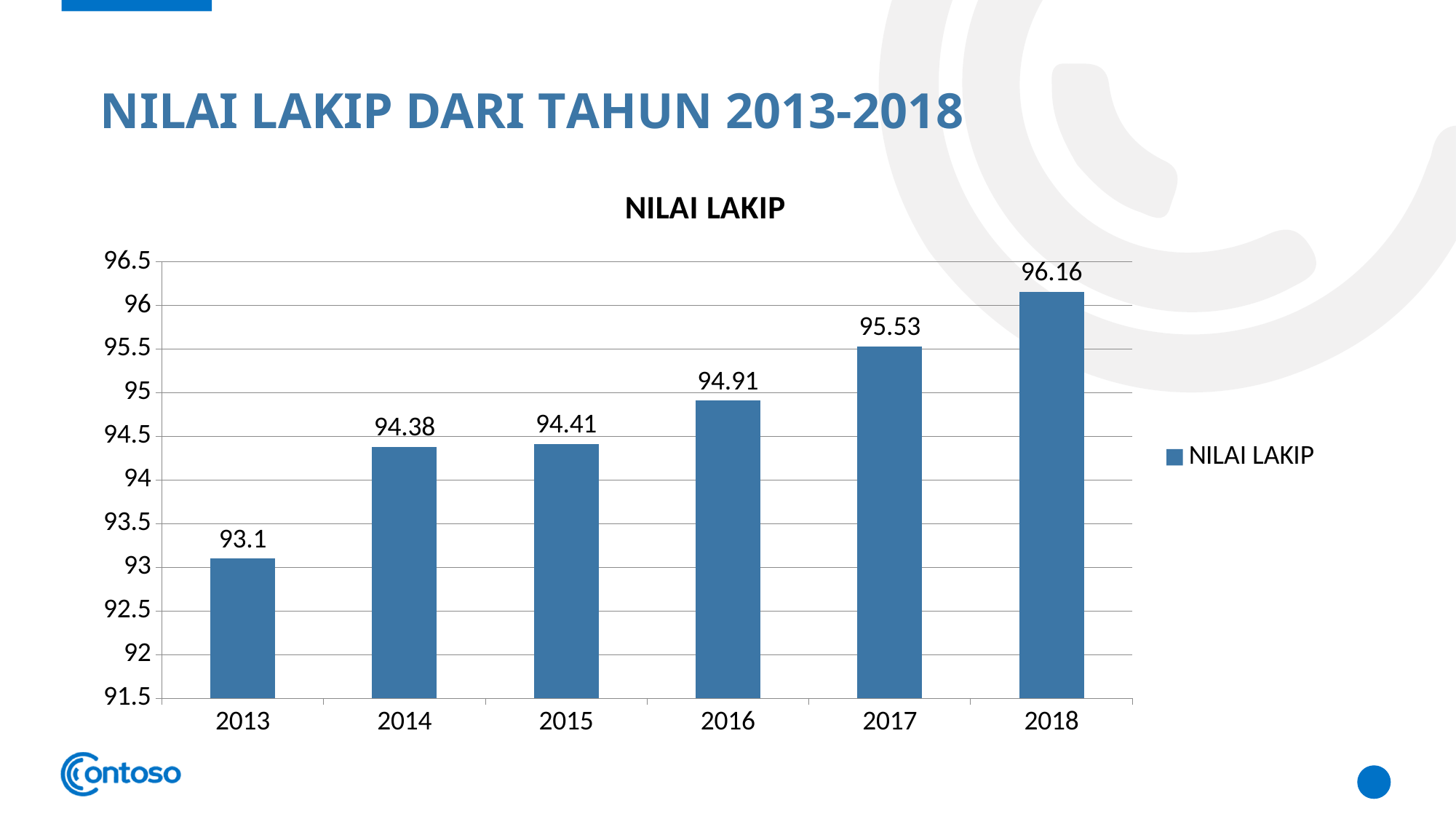
What is the difference between the NILAI LAKIP values for 2018 and 2013? 3.06 What is the NILAI LAKIP value for 2018? 96.16 Which year has the lowest NILAI LAKIP value? 2013 Do the NILAI LAKIP values rise or fall from 2013 to 2018? Rise What is the difference between the NILAI LAKIP values for 2017 and 2016? 0.62 What is the NILAI LAKIP value for 2013? 93.1 Which year has a larger NILAI LAKIP value, 2014 or 2017? 2017 Which year has the highest NILAI LAKIP value? 2018 What kind of chart is shown on the slide? Bar chart How many years are shown on the x axis of the chart? 6 What is the NILAI LAKIP value for 2016? 94.91 Is the NILAI LAKIP value for 2017 greater or less than 95? greater